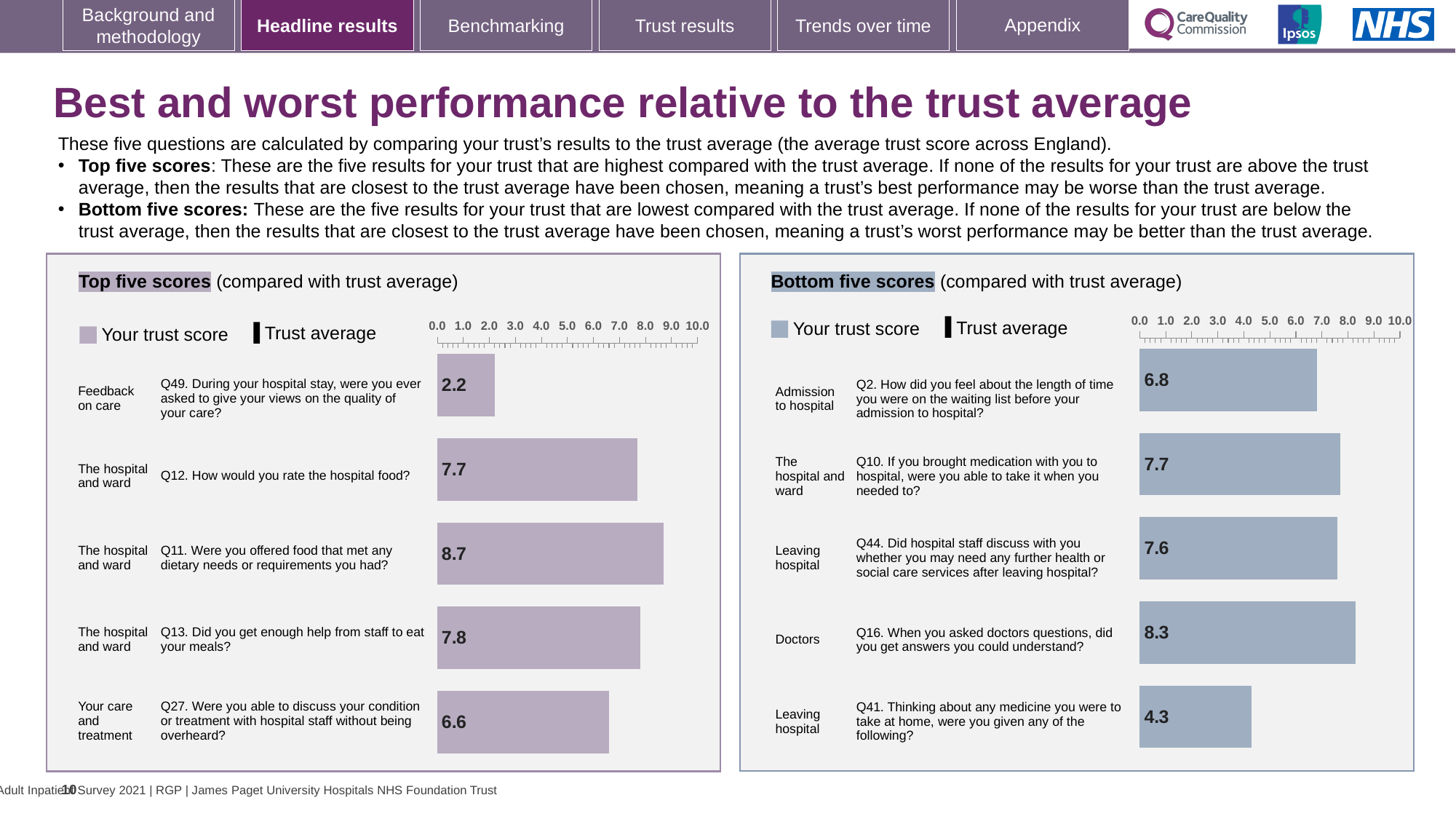
How many entries does the legend of the Top five scores chart list? 2 In the Bottom five scores chart, what is the trust score for Q41 (medicine to take at home)? 4.3 In the Top five scores chart, what is the trust score for Q27 (discussing your condition without being overheard)? 6.6 In the Top five scores chart, what is the trust score for Q12 (How would you rate the hospital food?)? 7.7 How many bars are plotted in the Top five scores chart? 5 In the Top five scores chart, which question has the highest trust score? Q11 (8.7) In the Bottom five scores chart, which question has the highest trust score? Q16 (8.3) What type of chart is used for the Bottom five scores? Bar chart In the Bottom five scores chart, which question has the lowest trust score? Q41 (4.3) In the Top five scores chart, what is the difference between the scores for Q11 and Q49? 6.5 In the Bottom five scores chart, which has the larger score: Q2 (waiting list) or Q44 (further health or social care services)? Q44 (7.6) In the Top five scores chart, which question has the lowest trust score? Q49 (2.2)